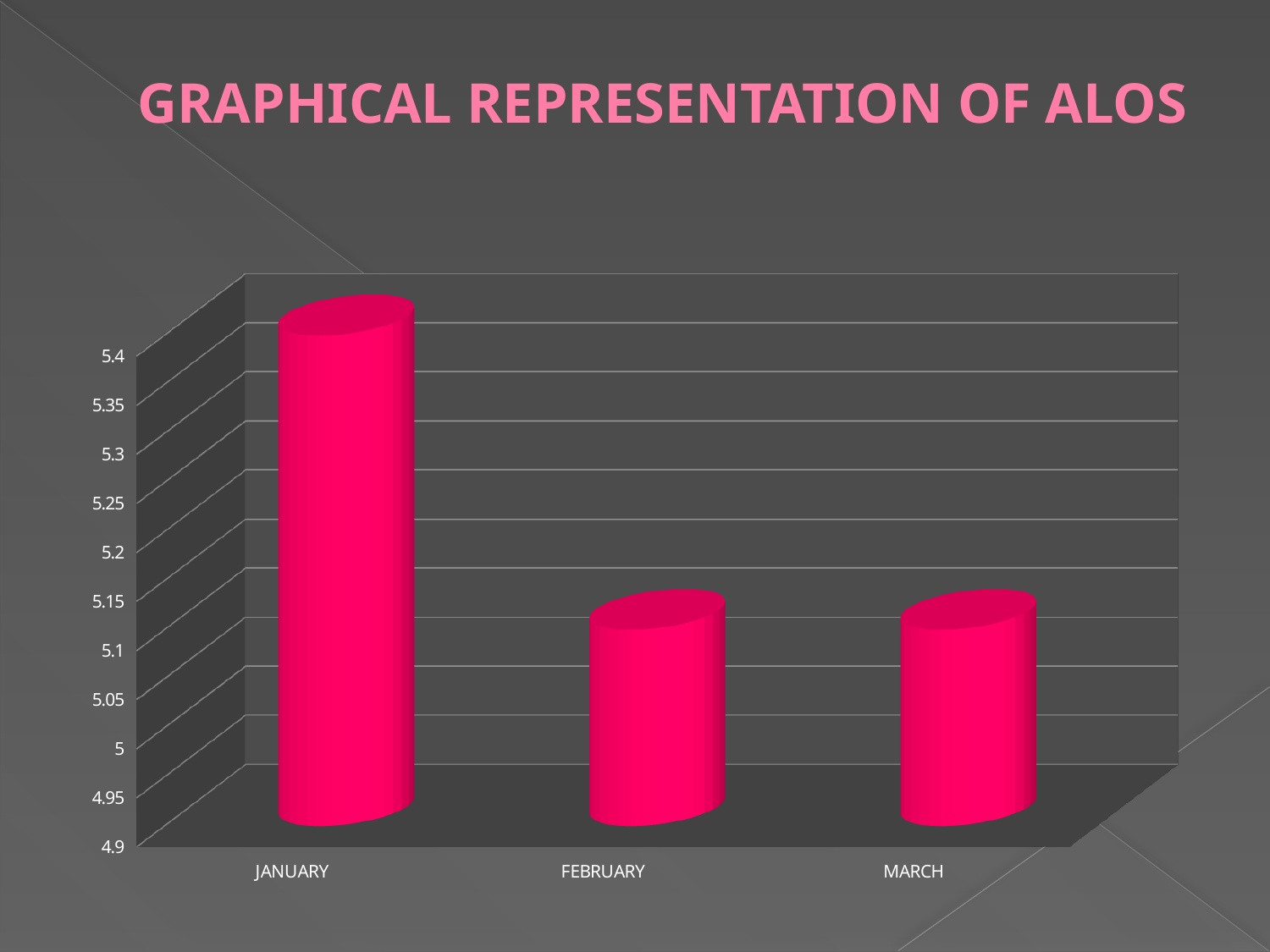
What kind of chart is shown on the slide? bar chart What is the title of the slide containing the chart? GRAPHICAL REPRESENTATION OF ALOS Which month has the highest value on the chart? JANUARY Is the value for MARCH greater or less than 5.3? less Is the value for FEBRUARY greater or less than 5.3? less Is the value for MARCH greater or less than 5? greater Do the values rise or fall from JANUARY to FEBRUARY? fall Which is larger, the value for MARCH or the value for JANUARY? JANUARY Which is larger, the value for JANUARY or the value for FEBRUARY? JANUARY How many categories are plotted on the chart? 3